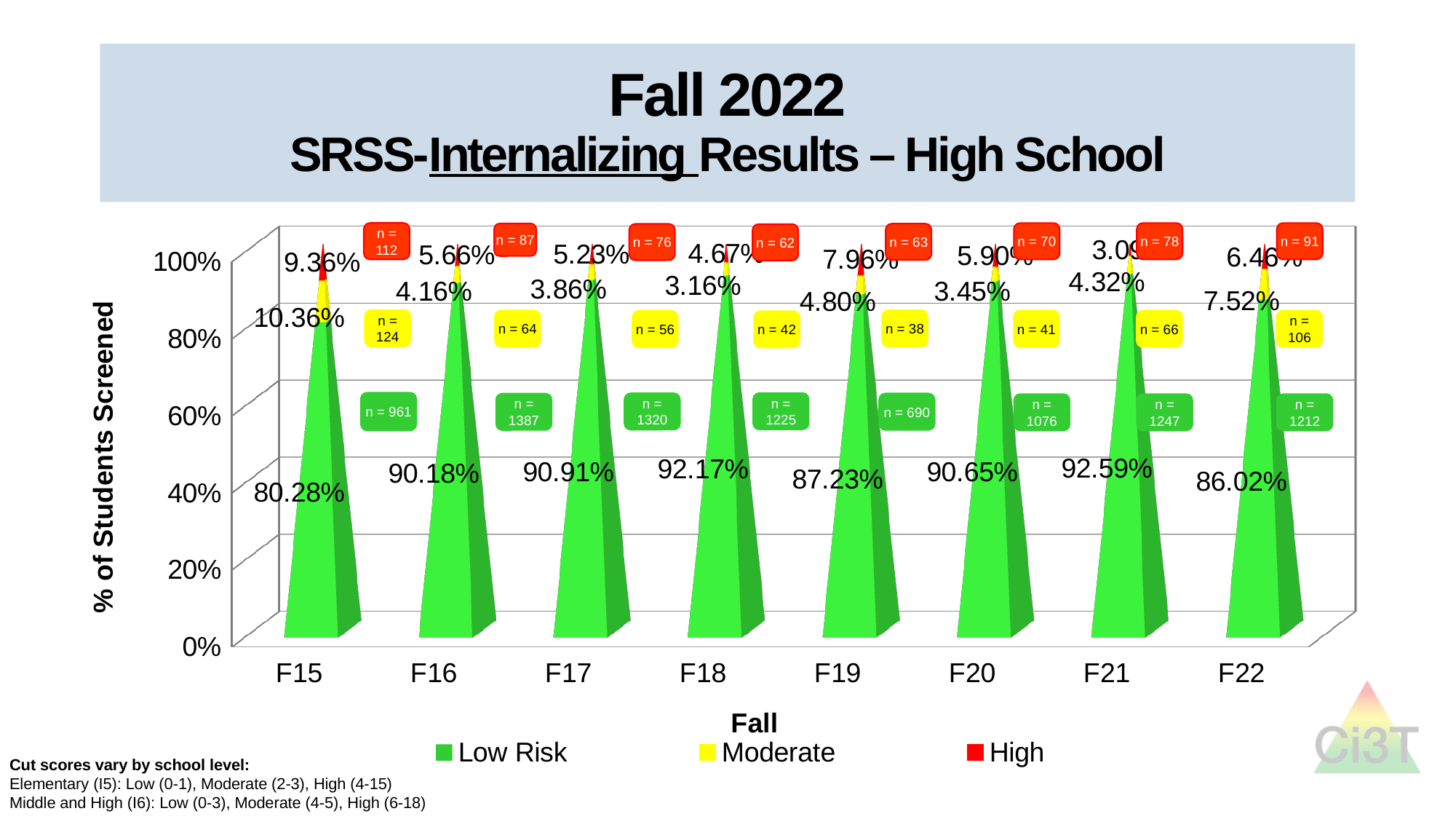
What is the n (number of students) for the Low Risk group in F16? 1387 Is the Low Risk percentage higher in F18 or in F19? F18 How many series does the legend list? 3 What percentage of students screened were Low Risk in F15? 80.28% What is the High percentage for F19? 7.96% Which fall has the highest Moderate percentage? F15 Which fall has the lowest Low Risk percentage? F15 What is the Moderate percentage for F22? 7.52% Which fall has the highest Low Risk percentage? F21 Is the Low Risk value for F22 greater or less than 80%? greater How many fall screening periods are shown on the x axis? 8 What is the difference between the Low Risk percentage in F21 and in F15? 12.31 percentage points